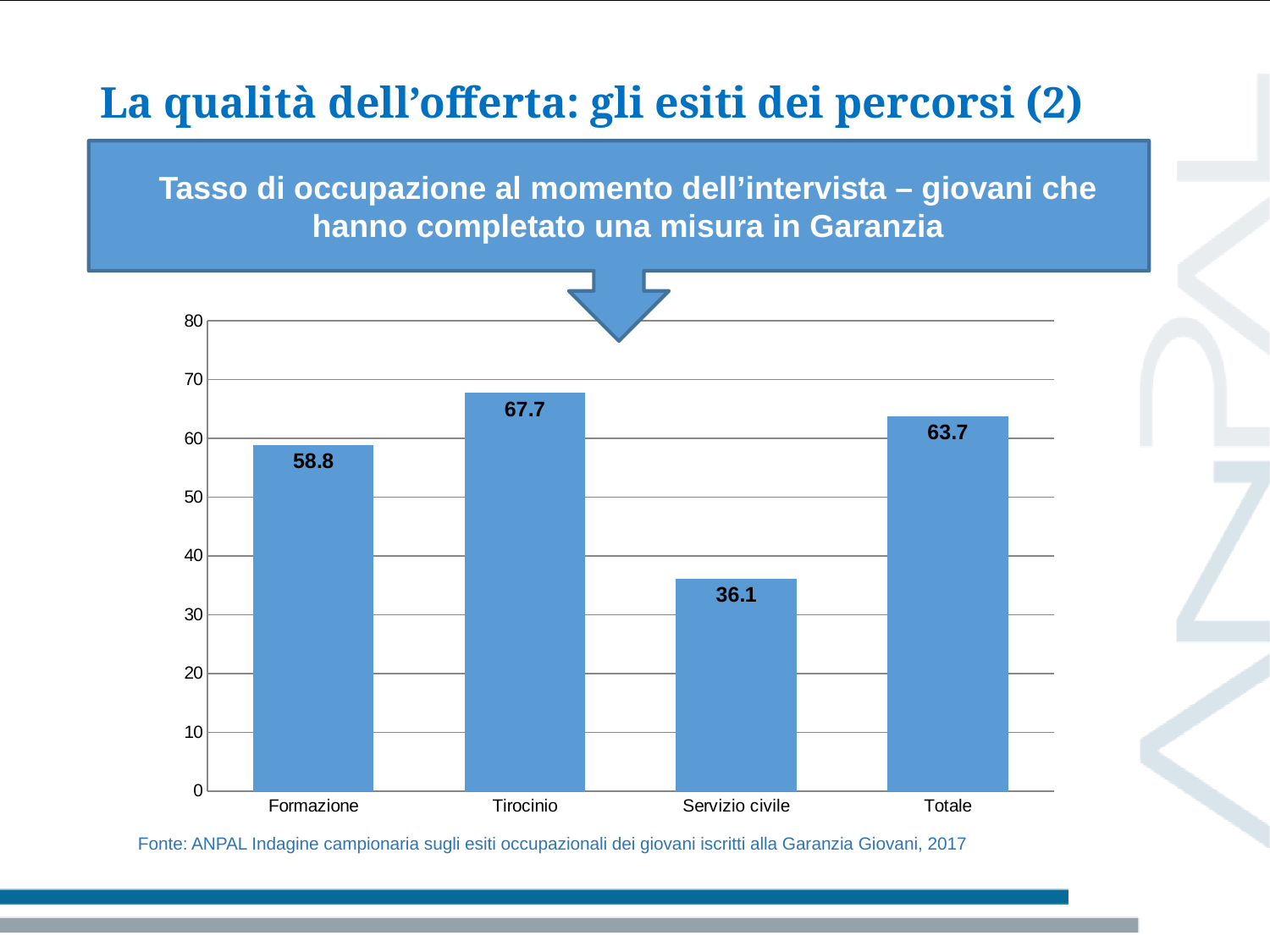
What is the difference between the values for Totale and Formazione? 4.9 Which is larger, the value for Formazione or the value for Totale? Totale What is the difference between the values for Tirocinio and Servizio civile? 31.6 What is the value for Formazione? 58.8 What kind of chart is shown on the slide? bar chart What is the value for Servizio civile? 36.1 Is the value for Servizio civile greater or less than 40? less Which category has the highest value? Tirocinio Which category has the lowest value? Servizio civile What is the value for Totale? 63.7 How many categories are shown on the x axis? 4 What is the value for Tirocinio? 67.7